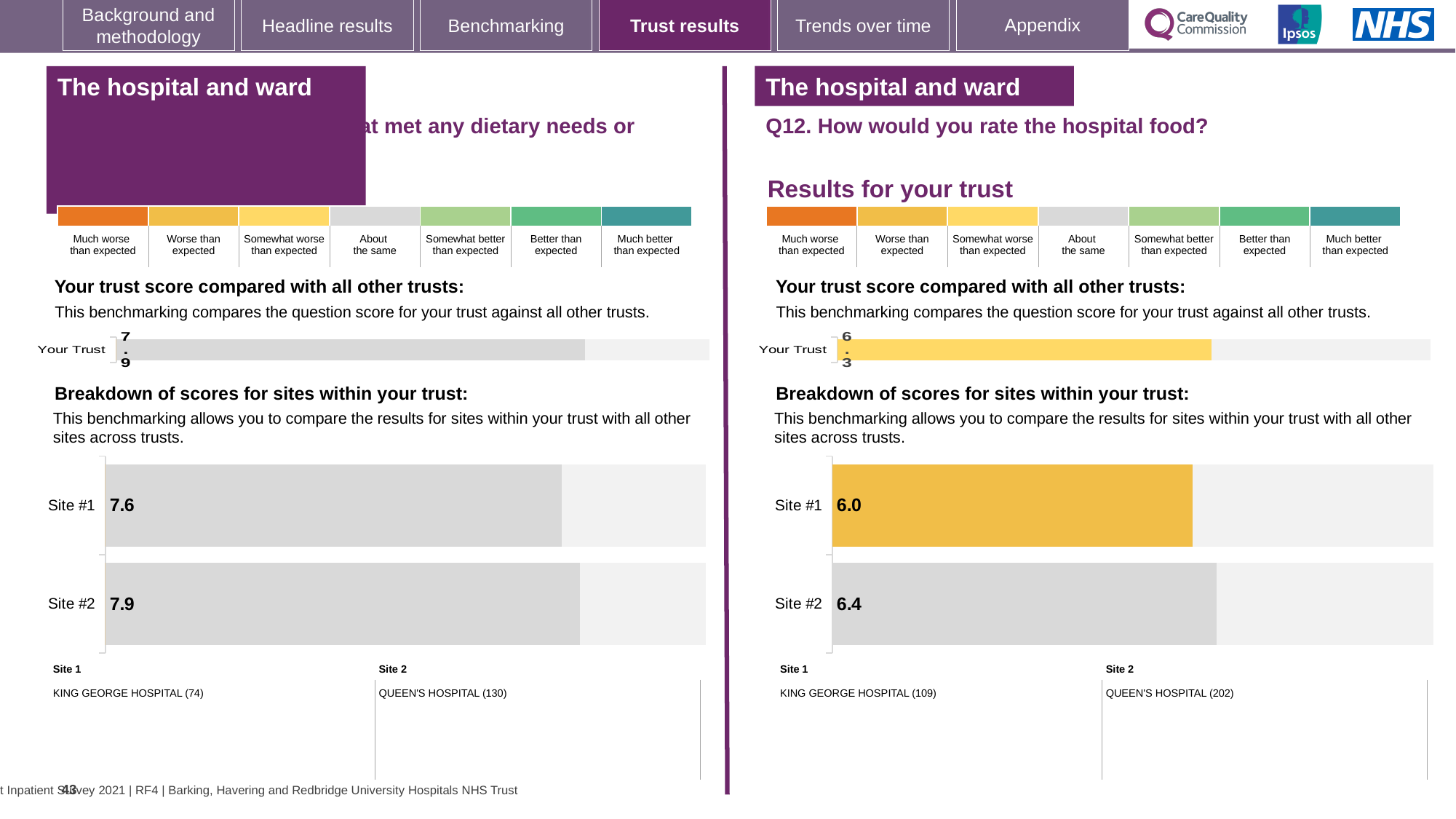
On the left-hand site breakdown chart, what is the score for Site #2? 7.9 On the left-hand site breakdown chart, what is the difference between the Site #2 and Site #1 scores? 0.3 How many sites are shown in the right-hand site breakdown chart? 2 On the left-hand site breakdown chart, what is the score for Site #1? 7.6 On the left-hand 'Your trust score compared with all other trusts' chart, what is the score shown for Your Trust? 7.9 What type of chart is used for the site breakdown on the right-hand side of the slide? Bar chart On the right-hand chart (Q12, hospital food), what is the score for Site #2? 6.4 On the right-hand site breakdown chart, what is the difference between the Site #2 and Site #1 scores? 0.4 On the right-hand chart (Q12, hospital food), what is the score for Site #1? 6.0 On the right-hand 'Your trust score compared with all other trusts' chart, what is the score shown for Your Trust? 6.3 On the left-hand site breakdown chart, which site has the lower score? Site #1 On the right-hand site breakdown chart, which site has the higher score? Site #2